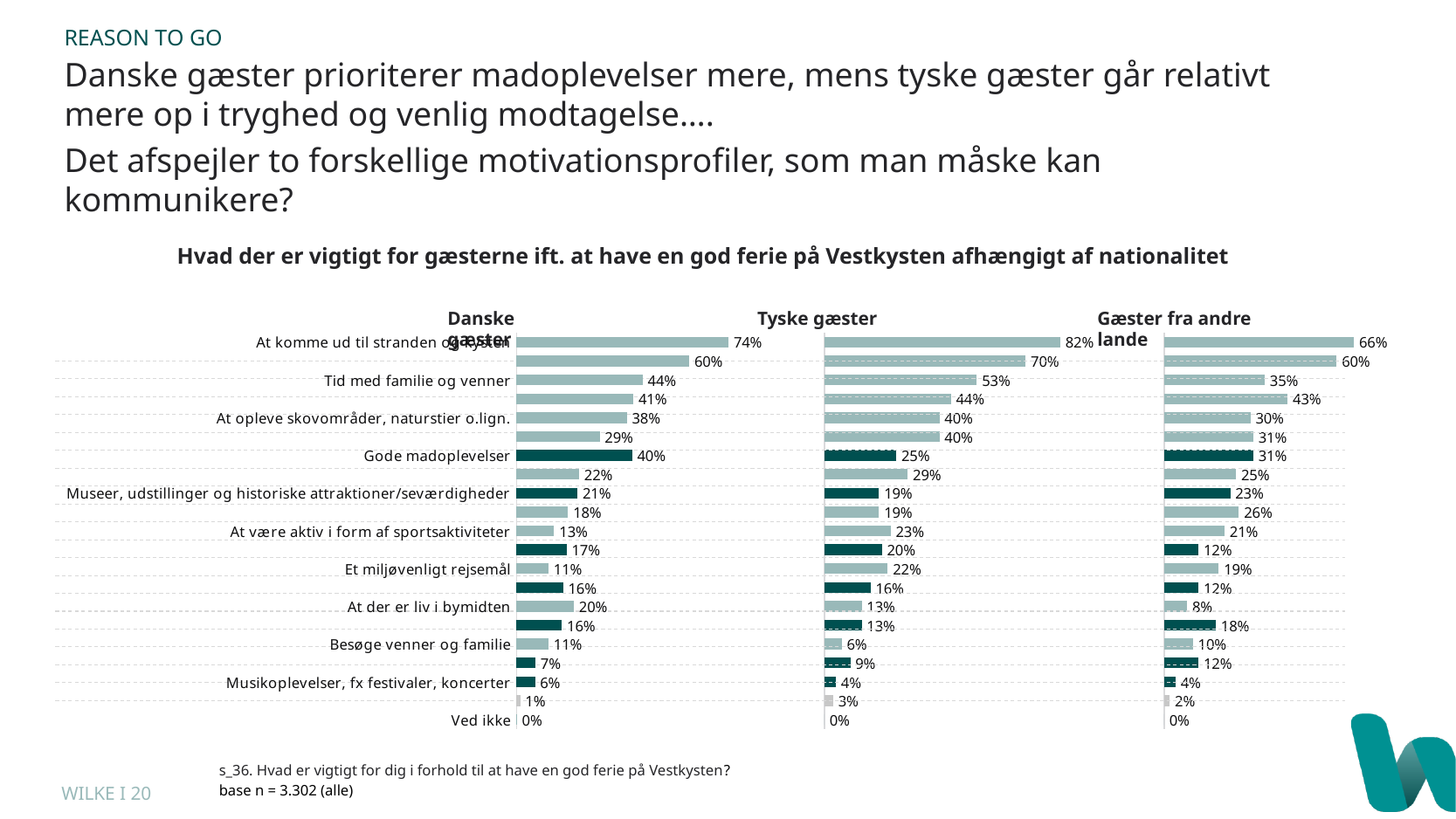
In the Danske gæster chart, what is the value for Gode madoplevelser? 40% What is the difference between the Danske gæster value and the Tyske gæster value for Gode madoplevelser? 15 percentage points What type of chart is used on this slide? Bar chart In the Gæster fra andre lande chart, which labelled category has the lowest value? Ved ikke In the Tyske gæster chart, what is the value for Et miljøvenligt rejsemål? 22% What is the difference between the Tyske gæster value and the Gæster fra andre lande value for At komme ud til stranden og kysten? 16 percentage points Which is larger for At der er liv i bymidten: the Danske gæster value or the Gæster fra andre lande value? Danske gæster In the Gæster fra andre lande chart, what is the value for Tid med familie og venner? 35% In the Danske gæster chart, which labelled category has the highest value? At komme ud til stranden og kysten In the Tyske gæster chart, what is the value for At komme ud til stranden og kysten? 82% Which is larger for At være aktiv i form af sportsaktiviteter: the Danske gæster value or the Tyske gæster value? Tyske gæster What is the title of the chart on the slide? Hvad der er vigtigt for gæsterne ift. at have en god ferie på Vestkysten afhængigt af nationalitet